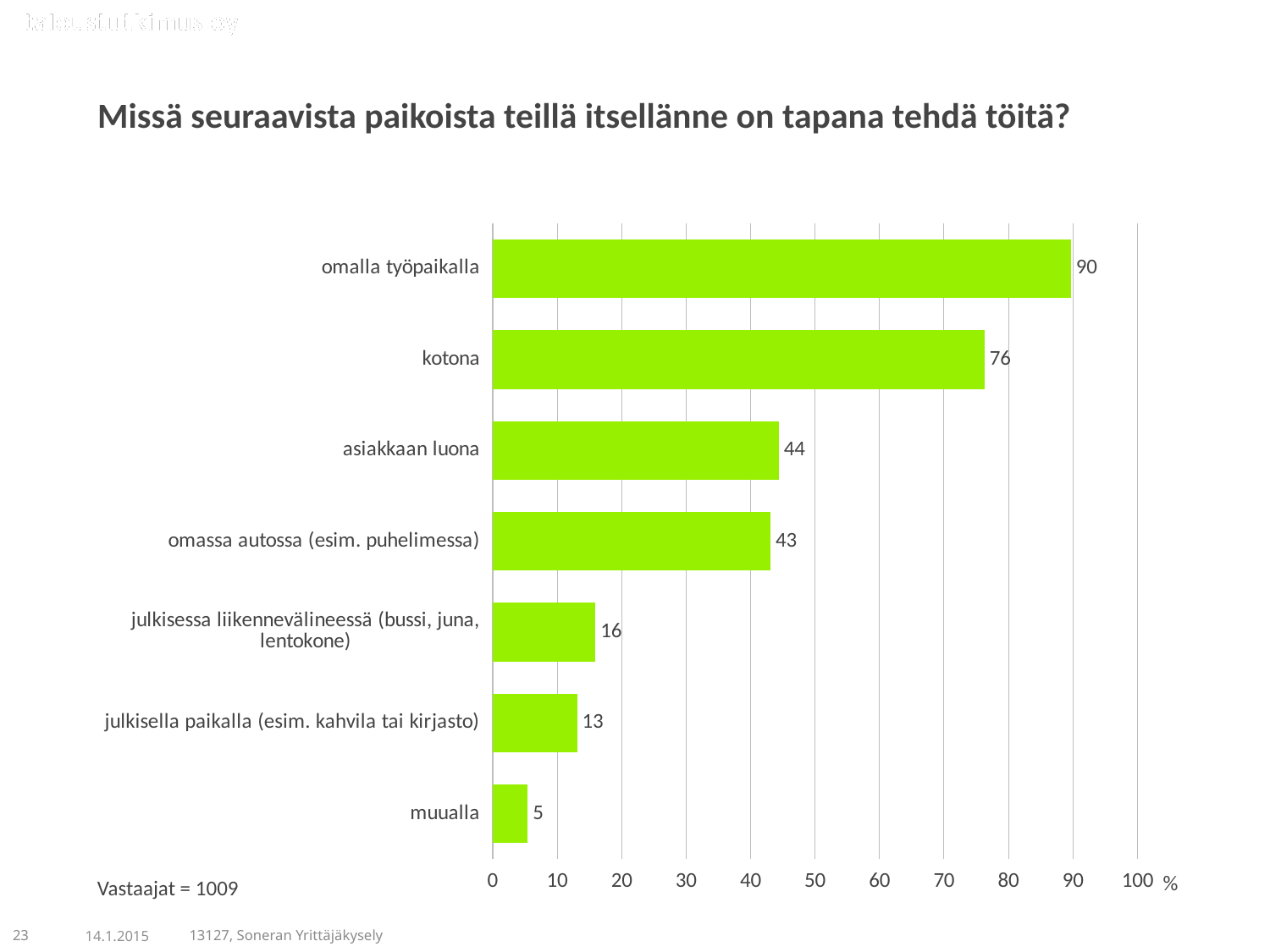
Which is larger, the value for "asiakkaan luona" or the value for "julkisessa liikennevälineessä (bussi, juna, lentokone)"? asiakkaan luona Which category has the highest value? omalla työpaikalla What is the difference between the values for "omalla työpaikalla" and "kotona"? 14 What is the title of the chart? Missä seuraavista paikoista teillä itsellänne on tapana tehdä töitä? What is the value for "kotona"? 76 What kind of chart is shown on the slide? bar chart What is the value for "julkisella paikalla (esim. kahvila tai kirjasto)"? 13 Is the value for "omassa autossa (esim. puhelimessa)" greater or less than 50? less How many categories are shown in the chart? 7 Which category has the lowest value? muualla What is the value for "omalla työpaikalla"? 90 What colour are the bars in the chart? green